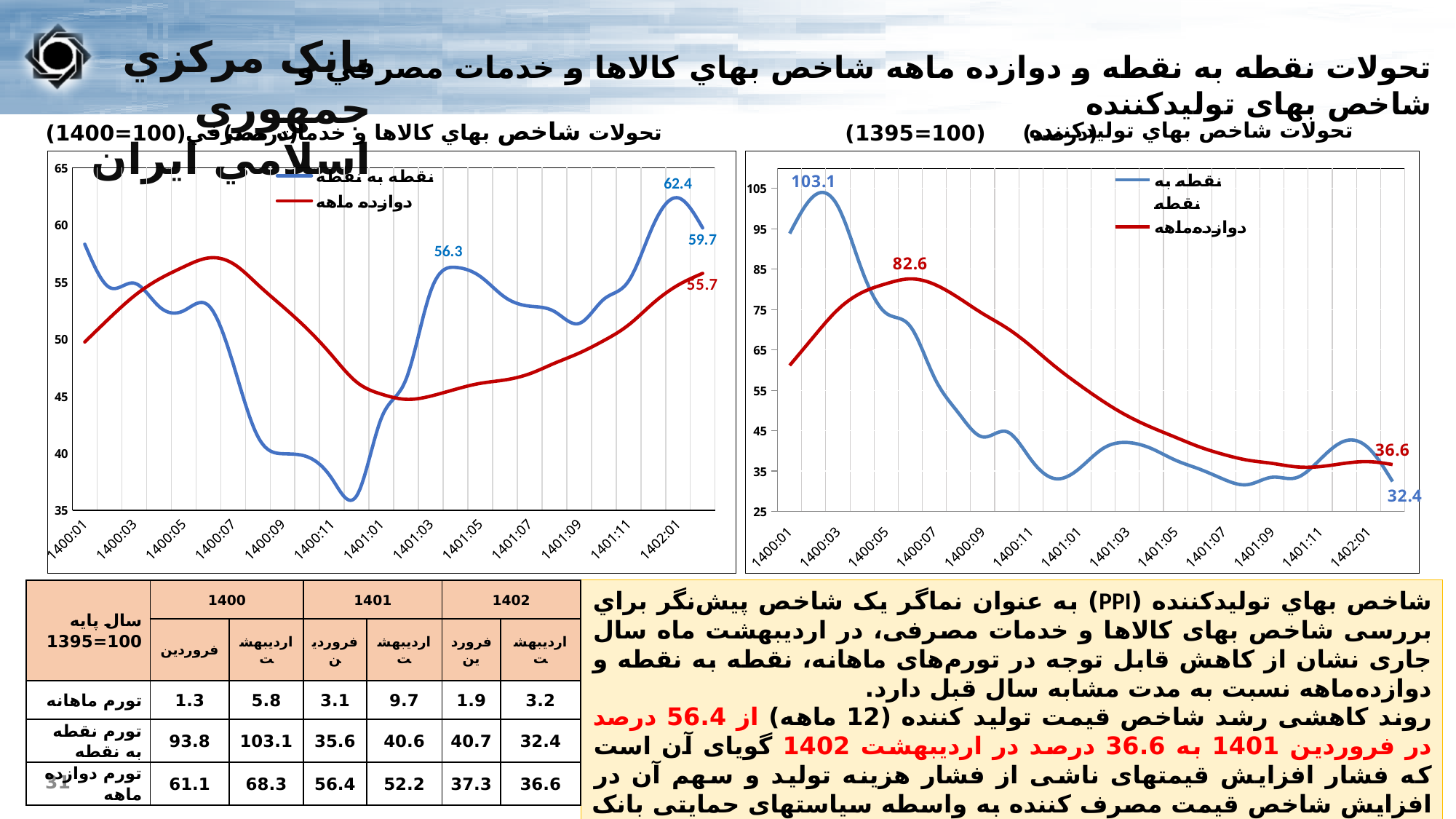
In the right chart (producer price index), what is the difference between the final labelled twelve-month value (36.6) and the final labelled point-to-point value (32.4)? 4.2 In the right chart (producer price index), what is the labelled peak value of the twelve-month (دوازده ماهه) series? 82.6 In the left chart (consumer price index), what is the labelled peak value of the point-to-point series near 1402:01? 62.4 In the right chart (producer price index), what is the labelled peak value of the point-to-point (نقطه به نقطه) series? 103.1 In the left chart (consumer price index), what is the difference between the two labelled peaks of the point-to-point series, 62.4 and 56.3? 6.1 In the left chart (consumer price index), what is the final labelled value of the twelve-month series? 55.7 In the right chart (producer price index), does the twelve-month series rise or fall from 1400:07 to the end of the chart? fall In the left chart (consumer price index), is the point-to-point value at 1400:12 greater or less than 40? less What kind of chart is the left chart (consumer goods and services price index, 1400=100)? line chart How many series does the legend of the right chart (producer price index, 1395=100) list? 2 In the left chart (consumer price index), which series has the higher final labelled value: point-to-point (59.7) or twelve-month (55.7)? point-to-point (نقطه به نقطه) In the right chart (producer price index), what is the final labelled value of the point-to-point series at the right end of the chart? 32.4